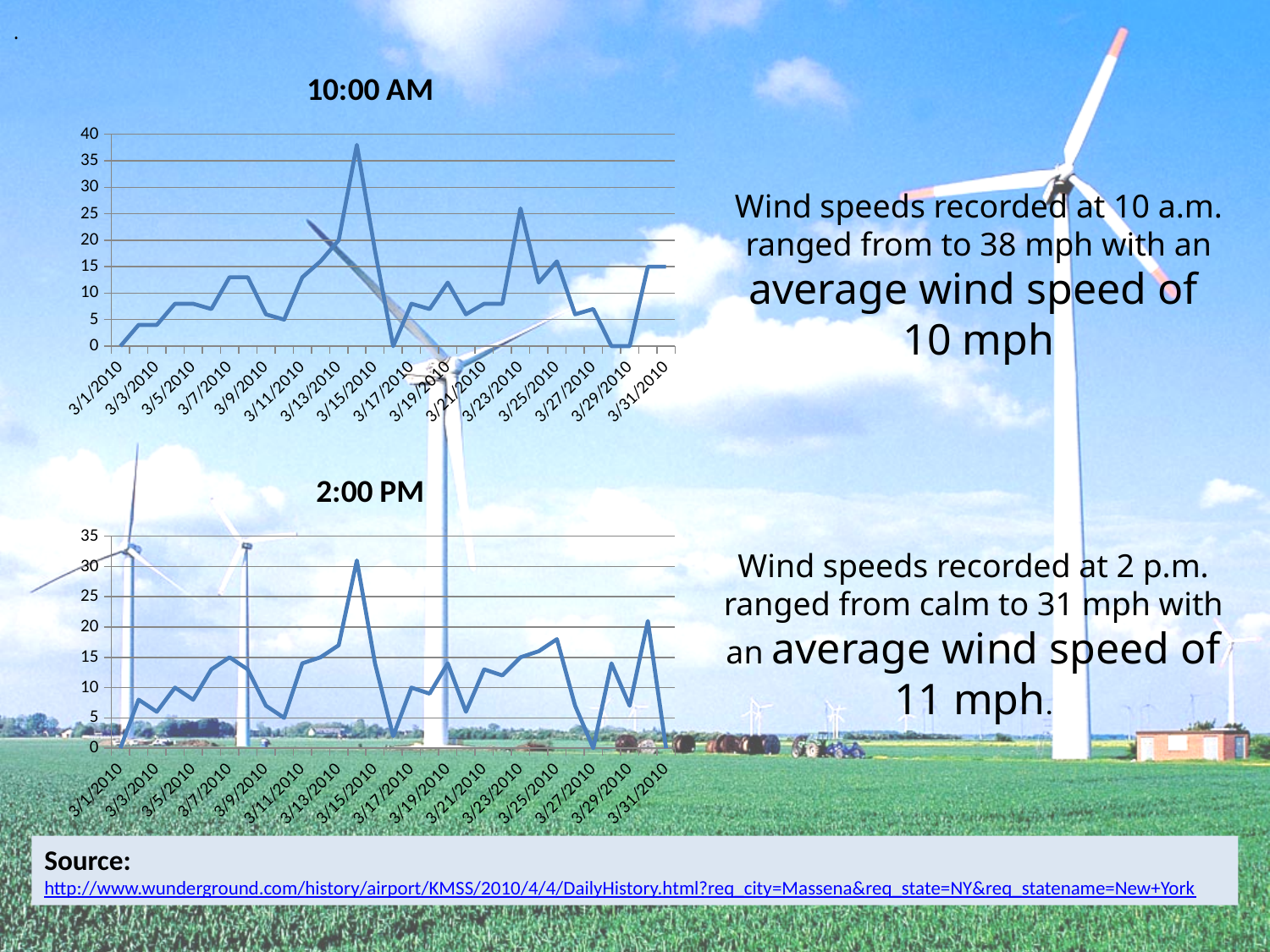
What is the title of the upper chart? 10:00 AM In the 10:00 AM chart, is the value for 3/1/2010 greater or less than 5? less How many charts are shown on the slide? 2 In the 2:00 PM chart, on which date does the wind speed reach its highest value? 3/14/2010 In the 2:00 PM chart, is the value for 3/27/2010 greater or less than 5? less What is the title of the lower chart? 2:00 PM In the 10:00 AM chart, is the value for 3/15/2010 greater or less than 35? less In the 10:00 AM chart, on which date does the wind speed reach its highest value? 3/14/2010 In the 10:00 AM chart, which is larger, the value for 3/15/2010 or the value for 3/25/2010? 3/15/2010 In the 2:00 PM chart, which is larger, the value for 3/15/2010 or the value for 3/31/2010? 3/15/2010 What kind of chart is the 10:00 AM chart? line chart